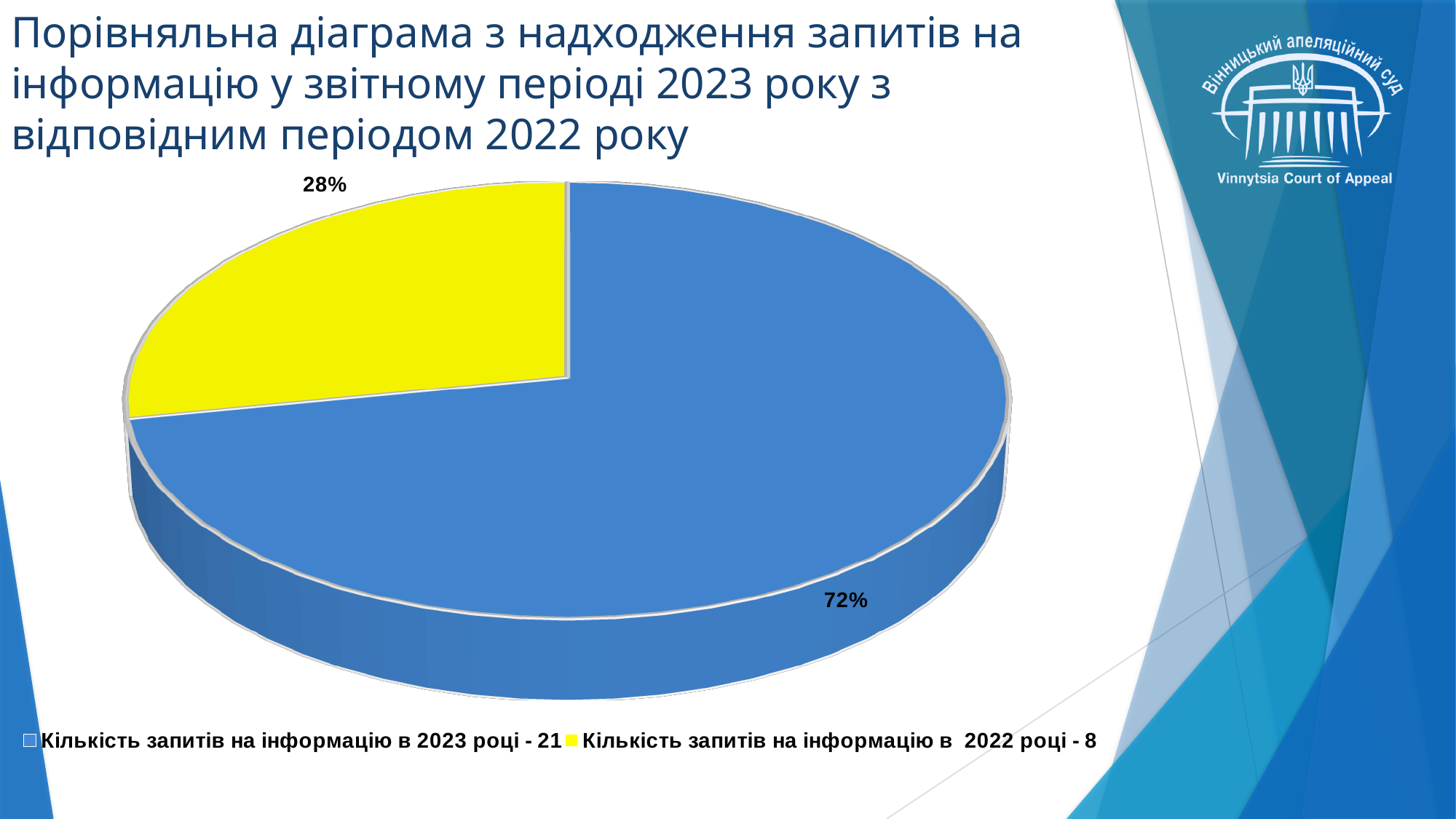
According to the legend, how many requests for information were received in 2022? 8 How many entries does the legend list? 2 What percentage share does the slice for requests for information in 2023 have? 72% What colour is the slice representing requests for information in 2022? yellow Which is larger: the share for 2023 or the share for 2022? 2023 What percentage share does the slice for requests for information in 2022 have? 28% What is the difference in percentage points between the 2023 slice and the 2022 slice? 44 Which slice is the largest in the pie chart? Кількість запитів на інформацію в 2023 році - 21 Which slice is the smallest in the pie chart? Кількість запитів на інформацію в 2022 році - 8 How many slices does the pie chart have? 2 According to the legend, how many requests for information were received in 2023? 21 What kind of chart is shown on the slide? pie chart